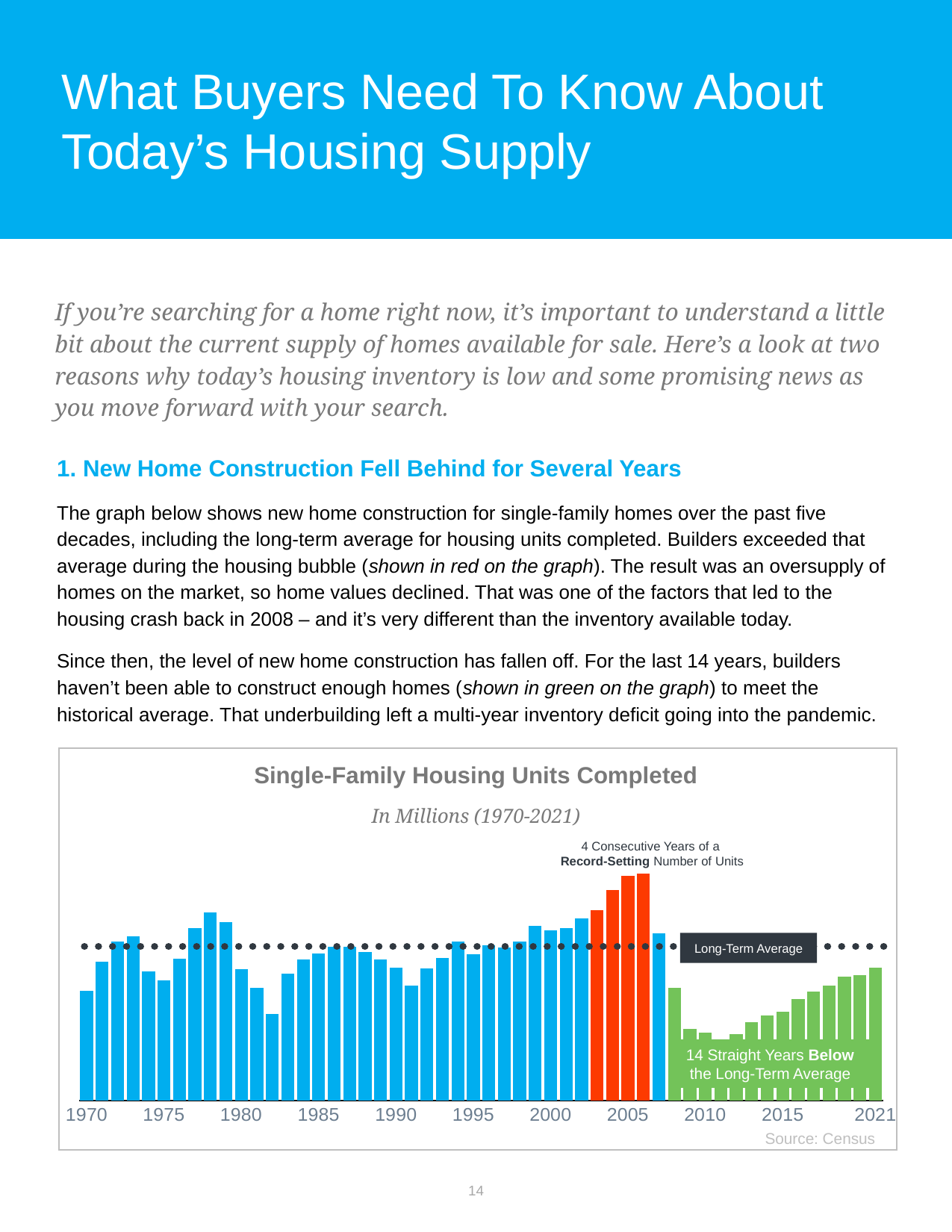
Do the bars rise or fall from 2006 to 2009? Fall What is the last year shown on the x axis of the chart? 2021 What does the dotted horizontal line on the chart represent? Long-Term Average What kind of chart is shown on the slide? Bar chart Which year has the highest bar on the chart? 2006 How many bars on the chart are coloured green? 14 Is the bar for 1978 taller or shorter than the bar for 1982? Taller What is the title of the chart? Single-Family Housing Units Completed Is the bar for 2006 taller or shorter than the bar for 2021? Taller How many bars on the chart are coloured red? 4 Do the green bars rise or fall from 2011 to 2021? Rise